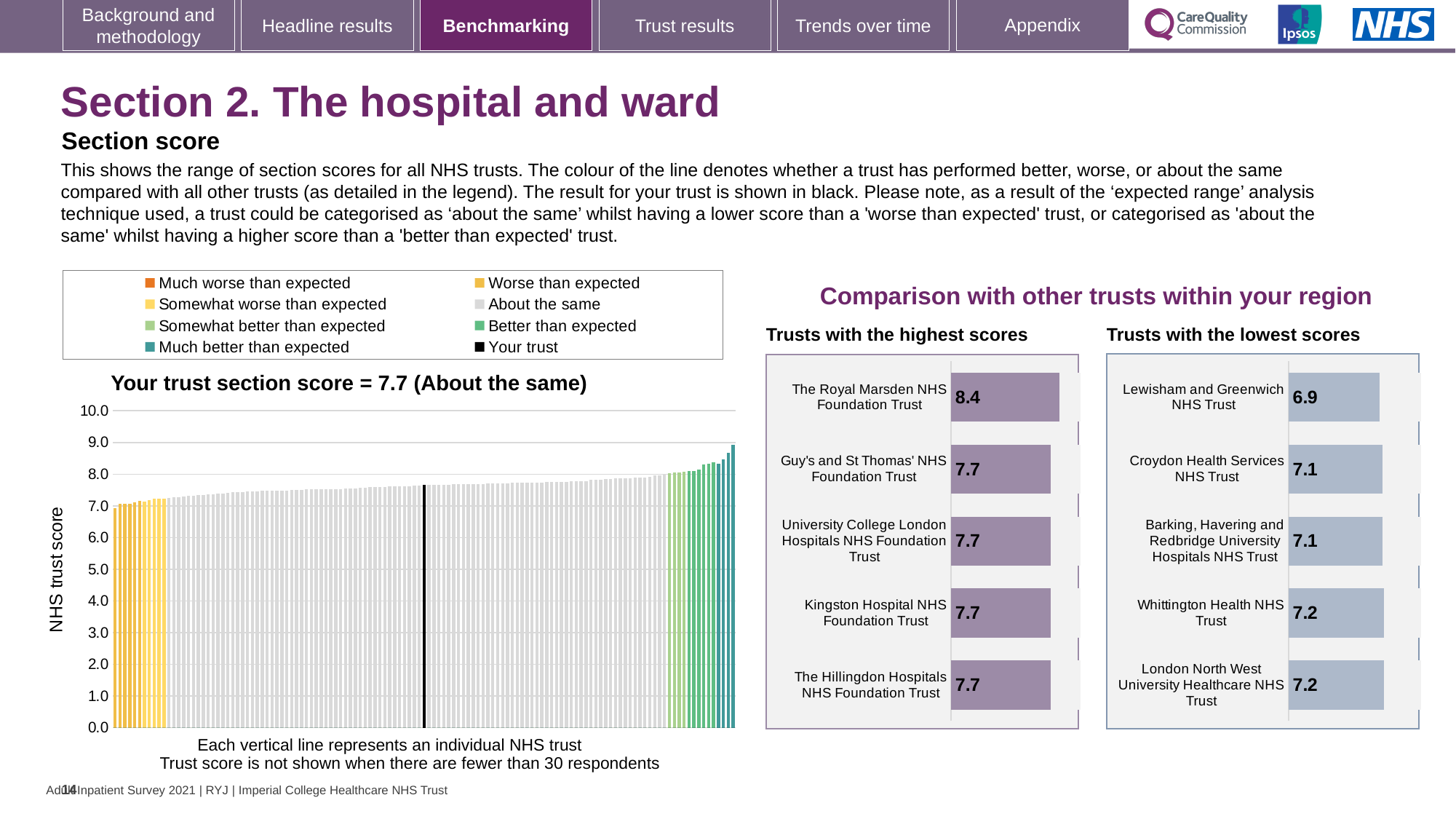
In the 'Trusts with the highest scores' chart, what is the difference between the scores of The Royal Marsden NHS Foundation Trust and Guy's and St Thomas' NHS Foundation Trust? 0.7 In the 'Trusts with the highest scores' chart, what is the score for The Royal Marsden NHS Foundation Trust? 8.4 What kind of chart is the main chart on the left showing the range of section scores for all NHS trusts? Bar chart In the main chart on the left, do the trust scores rise or fall from left to right? Rise In the 'Trusts with the lowest scores' chart, which trust has the lowest score? Lewisham and Greenwich NHS Trust In the 'Trusts with the lowest scores' chart, what is the score for Whittington Health NHS Trust? 7.2 In the 'Trusts with the lowest scores' chart, what is the difference between the scores of Whittington Health NHS Trust and Lewisham and Greenwich NHS Trust? 0.3 In the 'Trusts with the highest scores' chart, which trust has the highest score? The Royal Marsden NHS Foundation Trust How many trusts are shown in the 'Trusts with the highest scores' chart? 5 What is your trust's section score shown in the title of the main chart on the left? 7.7 In the 'Trusts with the lowest scores' chart, which has the larger score: Croydon Health Services NHS Trust or London North West University Healthcare NHS Trust? London North West University Healthcare NHS Trust In the 'Trusts with the lowest scores' chart, what is the score for Lewisham and Greenwich NHS Trust? 6.9